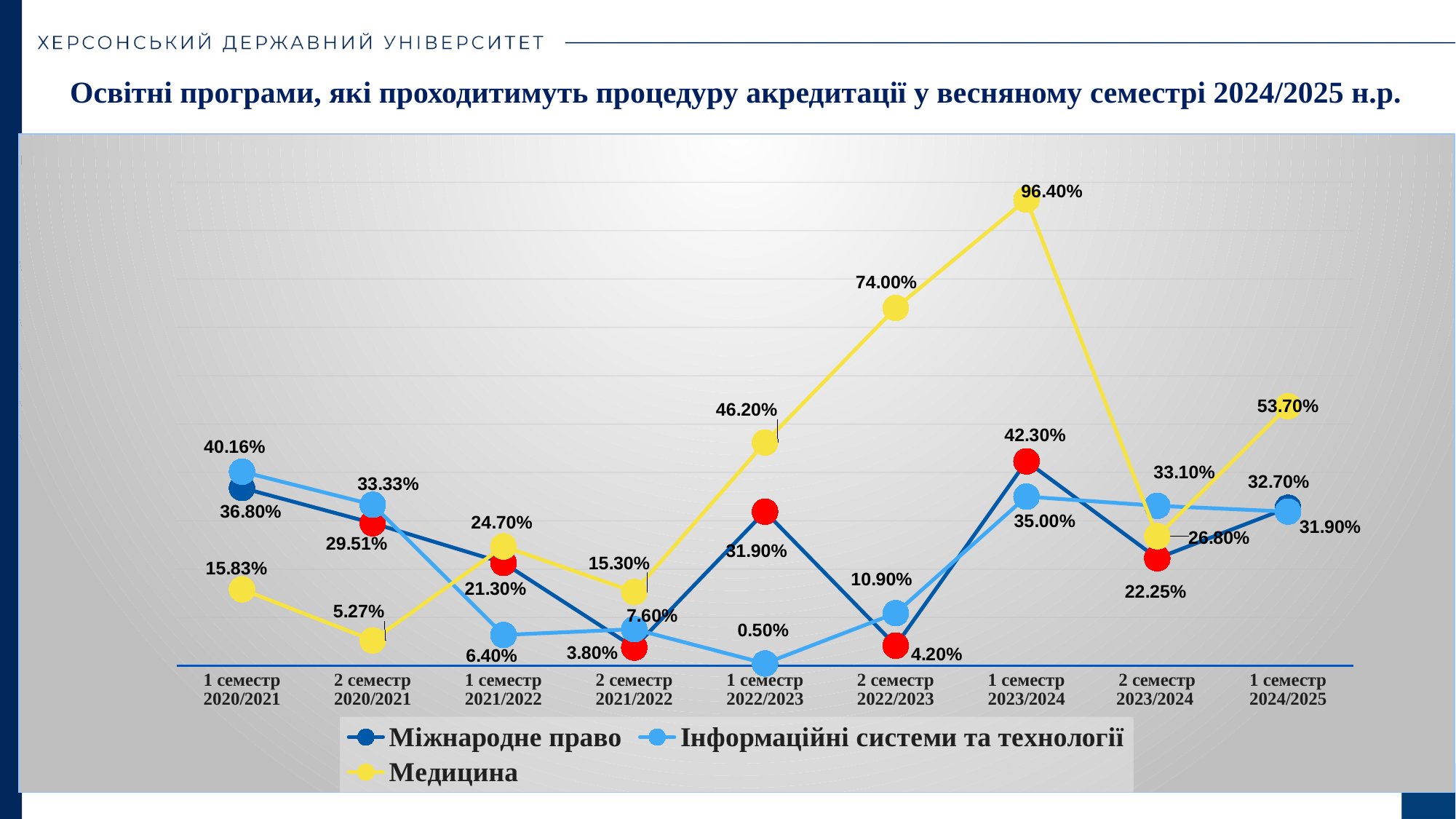
In 2 семестр 2022/2023, which is larger: Інформаційні системи та технології or Міжнародне право? Інформаційні системи та технології What colour is the Медицина line in the chart? Yellow How many semesters are shown along the x axis? 9 What is the value for Міжнародне право in 1 семестр 2020/2021? 36.80% In which semester does Інформаційні системи та технології have its lowest value? 1 семестр 2022/2023 What is the value for Медицина in 2 семестр 2020/2021? 5.27% What is the difference between the Медицина values in 1 семестр 2023/2024 and 2 семестр 2022/2023? 22.40% In which semester does Медицина reach its highest value? 1 семестр 2023/2024 What is the value for Медицина in 1 семестр 2023/2024? 96.40% Does the Медицина line rise or fall from 1 семестр 2022/2023 to 1 семестр 2023/2024? Rise What kind of chart is shown on the slide? Line chart How many series does the legend list? 3